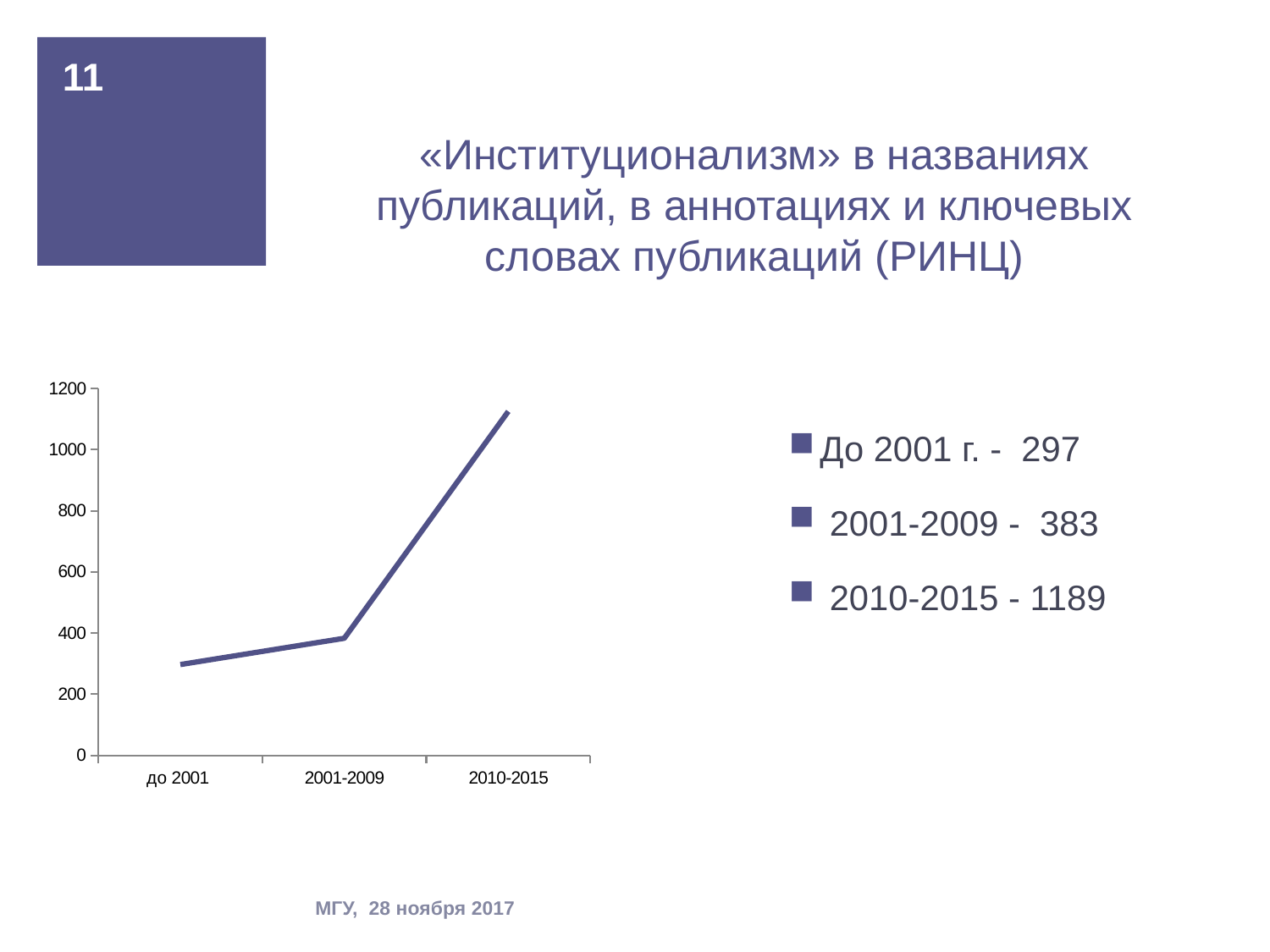
What kind of chart is shown on the slide? line chart What is the difference between the values for 2001-2009 and до 2001? 86 What is the value for the period до 2001? 297 What is the value for the period 2010-2015? 1189 Which period has the lowest value? до 2001 What is the value for the period 2001-2009? 383 Which period has the highest value? 2010-2015 What is the difference between the values for 2010-2015 and 2001-2009? 806 Which is larger, the value for 2001-2009 or the value for до 2001? 2001-2009 Do the values rise or fall from до 2001 to 2010-2015? rise How many points are plotted on the line chart? 3 Is the value for 2010-2015 greater or less than 1000? greater